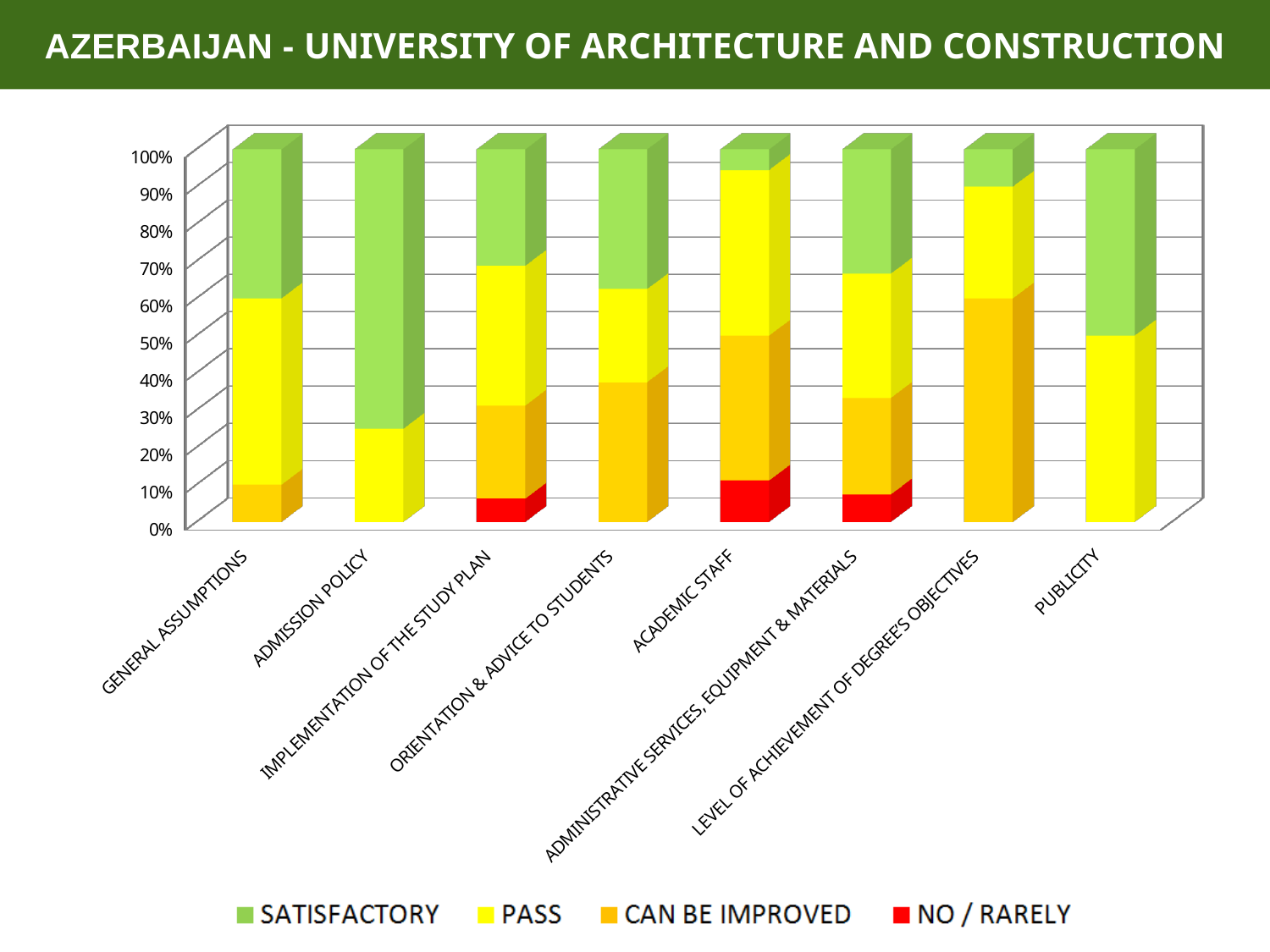
Which category has the largest SATISFACTORY share? ADMISSION POLICY Is the CAN BE IMPROVED share for LEVEL OF ACHIEVEMENT OF DEGREE'S OBJECTIVES greater or less than 50%? greater Which category has the largest CAN BE IMPROVED share? LEVEL OF ACHIEVEMENT OF DEGREE'S OBJECTIVES Is the SATISFACTORY share for ACADEMIC STAFF greater or less than 10%? less Which has the larger SATISFACTORY share, PUBLICITY or GENERAL ASSUMPTIONS? PUBLICITY How many categories include a NO / RARELY segment? 3 What kind of chart is shown on the slide? Stacked bar chart What colour represents the NO / RARELY series in the legend? Red Is the PASS share for ADMISSION POLICY greater or less than 40%? less How many series does the legend list? 4 How many categories are shown along the x axis? 8